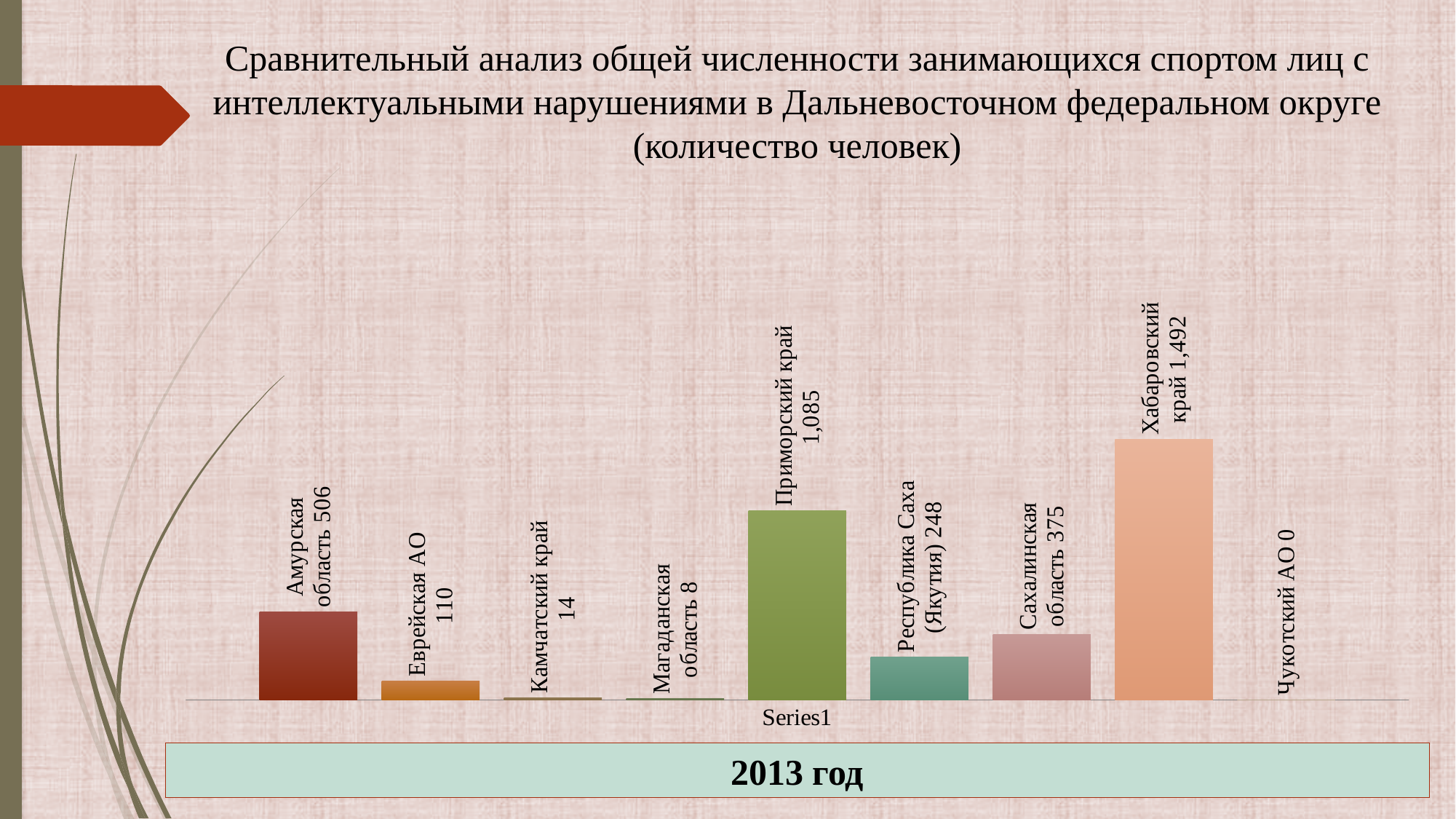
What year is shown in the box below the chart? 2013 год What is the value for Хабаровский край? 1,492 Which is larger, the value for Еврейская АО or the value for Камчатский край? Еврейская АО How many regions are shown in the chart? 9 What kind of chart is shown on the slide? Bar chart Which region has the highest value? Хабаровский край What is the value for Приморский край? 1,085 Which region has the lowest value? Чукотский АО What is the value for Магаданская область? 8 What is the value for Республика Саха (Якутия)? 248 What is the difference between the values for Хабаровский край and Приморский край? 407 What is the difference between the values for Амурская область and Сахалинская область? 131